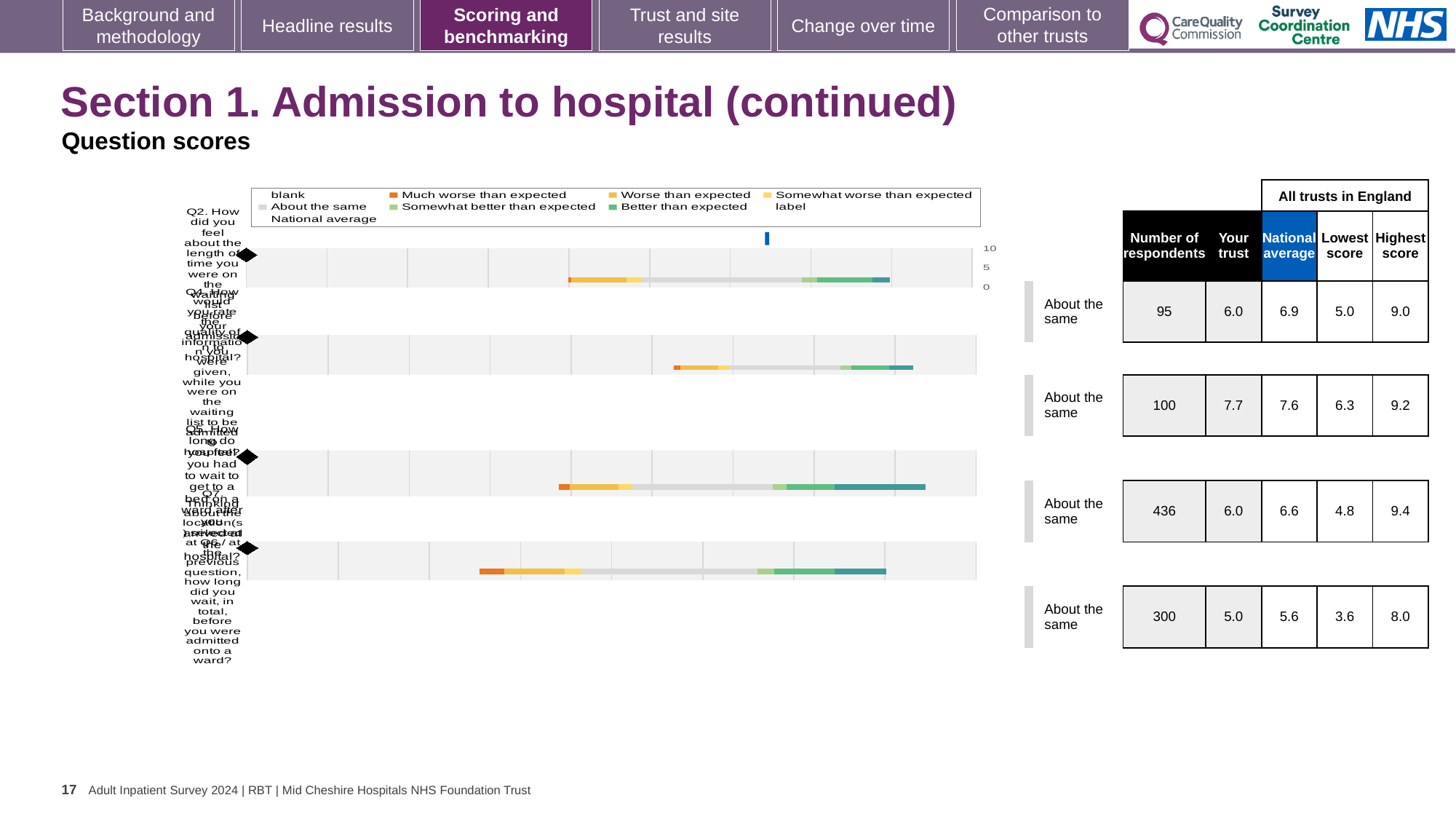
Which legend entry is shown in dark orange? Much worse than expected What kind of chart is shown on the slide? bar chart In the table next to the chart, which question row has the largest number of respondents? the third row (436) In the table next to the chart, what is the difference between the national average and 'Your trust' score in the first question row? 0.9 In the table next to the chart, what is the national average for the third question row? 6.6 In the table next to the chart, is the 'Your trust' score in the second row larger or smaller than the national average in that row? larger In the table next to the chart, what is the number of respondents for the first question row? 95 How many question bars are plotted in the chart? 4 What is the highest value shown on the chart's axis? 10 How many entries does the chart legend list? 9 In the table next to the chart, what is the 'Your trust' score for the second question row? 7.7 In the table next to the chart, what is the highest score for the fourth question row? 8.0